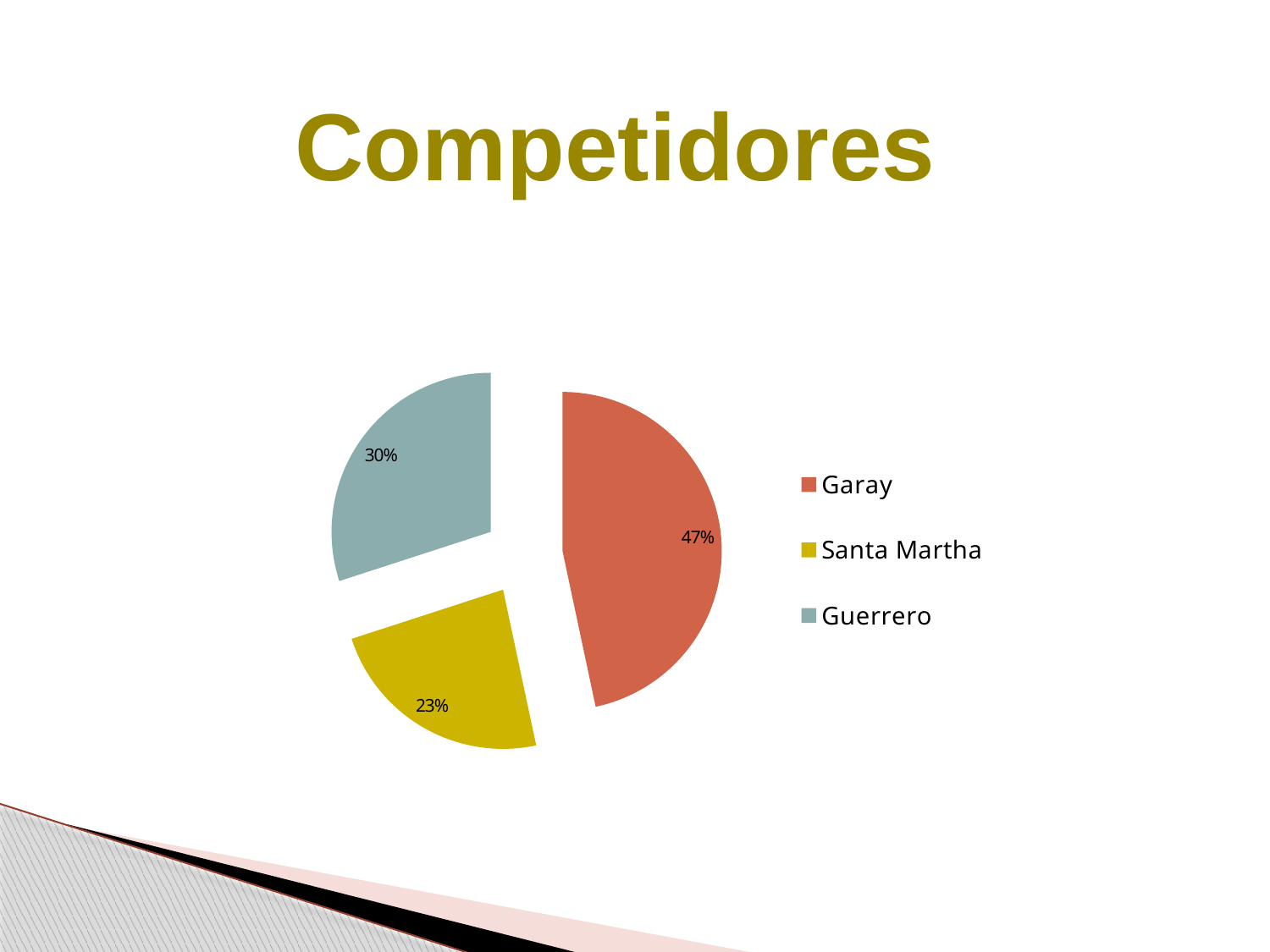
What is the difference in percentage points between Guerrero and Santa Martha? 7 What share of the pie does Santa Martha have? 23% Which competitor has the smallest slice of the pie? Santa Martha What share of the pie does Guerrero have? 30% What is the title of the slide containing the pie chart? Competidores How many slices does the pie chart have? 3 What kind of chart is shown on the slide? pie chart What share of the pie does Garay have? 47% What is the difference in percentage points between Garay and Santa Martha? 24 Which competitor is represented by the red slice? Garay Which is larger, the share for Guerrero or the share for Santa Martha? Guerrero Which competitor has the largest slice of the pie? Garay